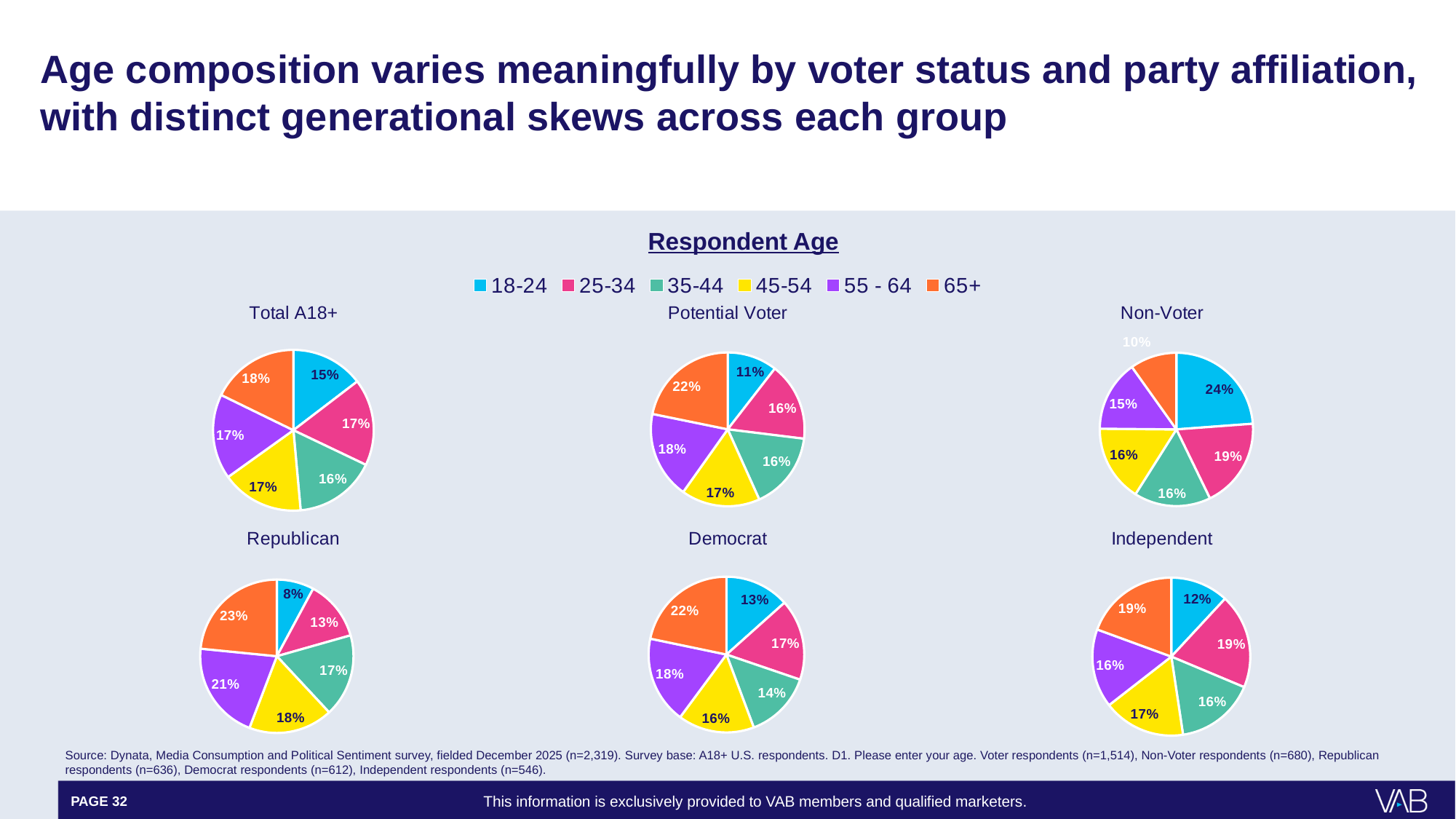
How many age groups does the legend list? 6 In the Non-Voter pie chart, what share of respondents are aged 18-24? 24% In the Democrat pie chart, what share of respondents are aged 35-44? 14% In the Republican pie chart, what share of respondents are aged 18-24? 8% In the Republican pie chart, which age group has the largest share? 65+ How many pie charts are shown on the slide? 6 In the Republican pie chart, what is the difference between the 65+ share and the 18-24 share? 15% What type of chart is used for the Total A18+ group? Pie chart In the Non-Voter pie chart, which age group has the smallest share? 65+ Which colour represents the 45-54 age group in the legend? Yellow In the Potential Voter pie chart, what share of respondents are aged 65+? 22% In the Independent pie chart, which is larger: the 25-34 share or the 18-24 share? 25-34